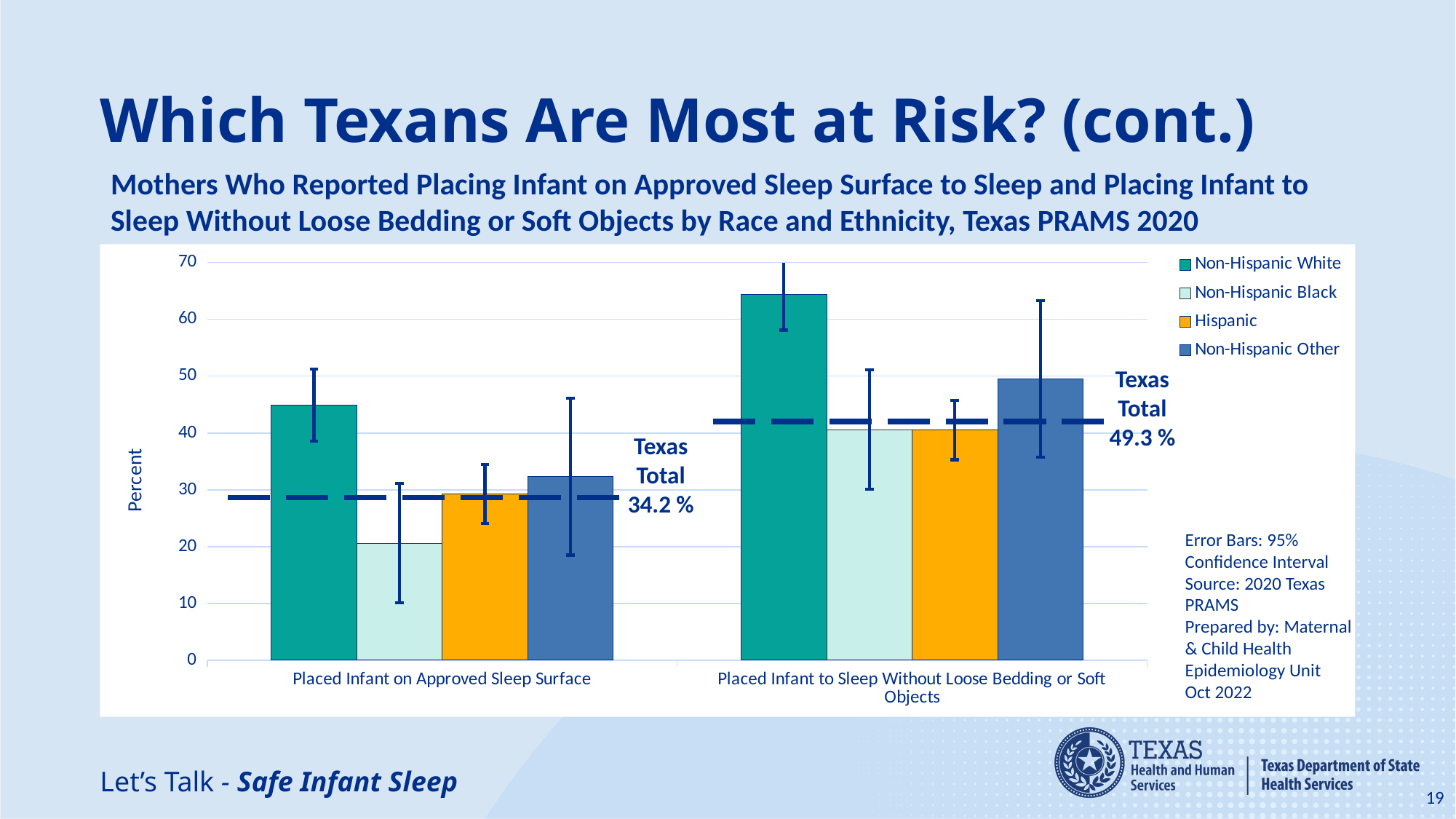
Which group has the lowest bar for Placed Infant on Approved Sleep Surface? Non-Hispanic Black What kind of chart is shown on the slide? bar chart Is the value for Non-Hispanic Black for Placed Infant on Approved Sleep Surface greater or less than 30? less Which group has the highest bar for Placed Infant on Approved Sleep Surface? Non-Hispanic White How many series does the legend list? 4 Is the value for Non-Hispanic Other for Placed Infant to Sleep Without Loose Bedding or Soft Objects greater or less than 60? less What is the Texas Total shown for Placed Infant on Approved Sleep Surface? 34.2 % Is the value for Non-Hispanic White for Placed Infant on Approved Sleep Surface greater or less than 40? greater What do the error bars on the chart represent? 95% Confidence Interval How many categories are shown on the x axis? 2 Which group has the highest bar for Placed Infant to Sleep Without Loose Bedding or Soft Objects? Non-Hispanic White What is the Texas Total shown for Placed Infant to Sleep Without Loose Bedding or Soft Objects? 49.3 %